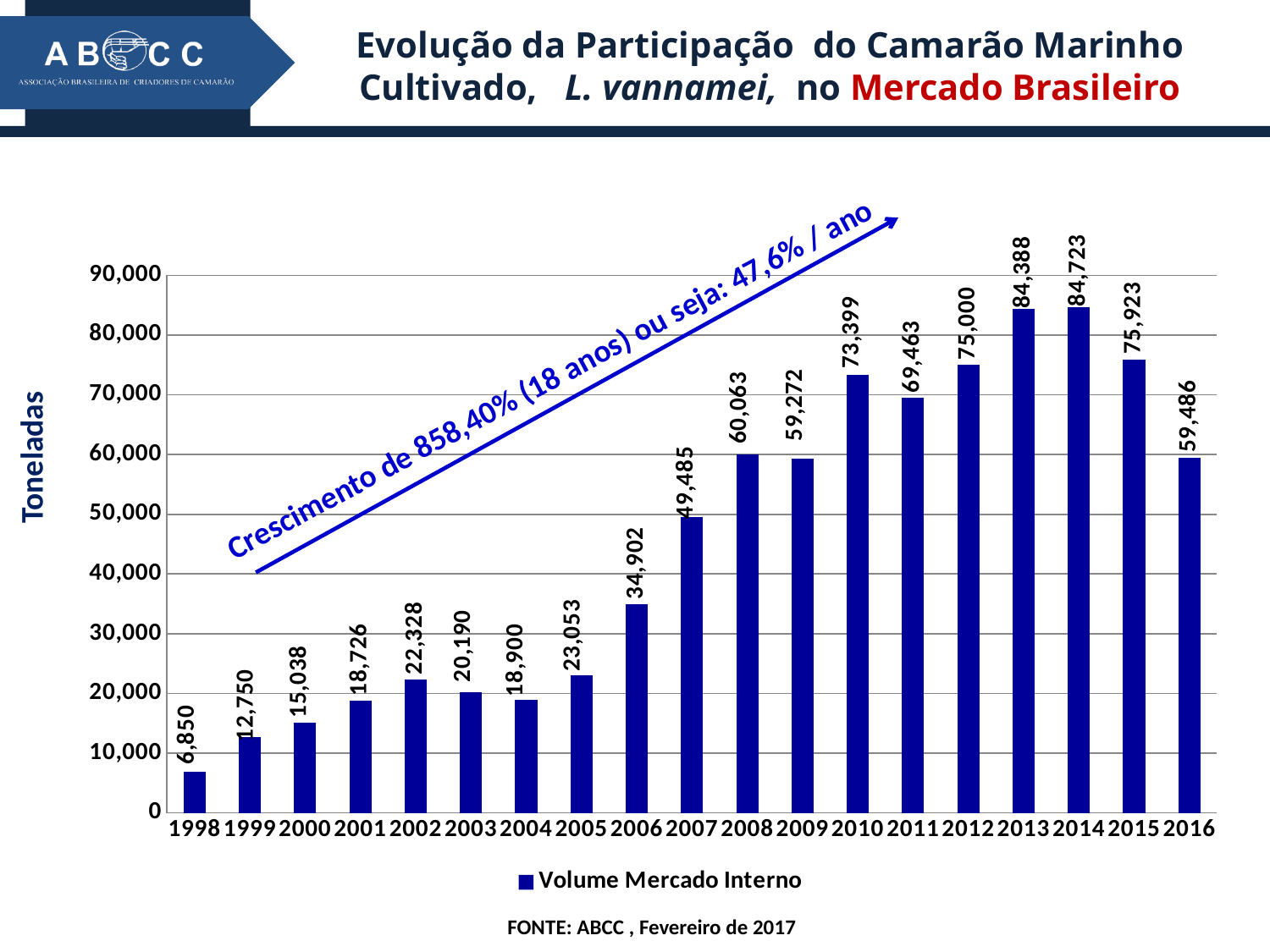
Is the value for 2006 greater or less than 30,000? greater What kind of chart is shown on the slide? Bar chart How many series does the legend list? 1 What is the value for 2016? 59,486 Which year has the lowest value? 1998 How many years are shown on the x axis? 19 Which is larger, the value for 2008 or the value for 2009? 2008 Which year has the highest value? 2014 What is the value for 2010? 73,399 What is the difference between the values for 2015 and 2016? 16,437 What is the difference between the values for 2014 and 2013? 335 What is the value for 1998? 6,850